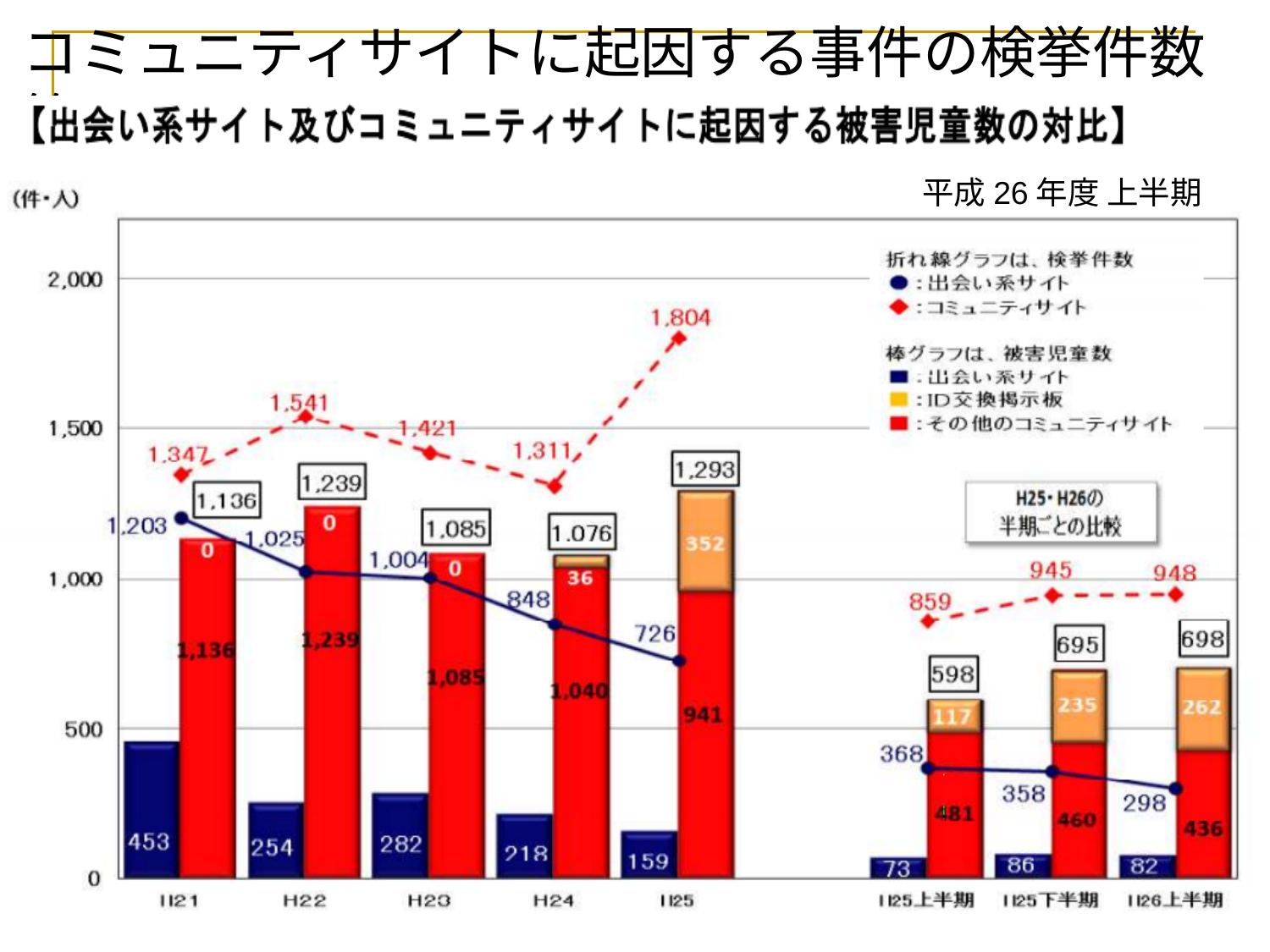
What is the value of the 出会い系サイト line (検挙件数) for H21? 1,203 How many categories are shown on the x axis? 8 What unit is shown at the top of the y axis? (件・人) Does the 出会い系サイト line rise or fall from H21 to H25? fall What is the total of the stacked bar (被害児童数) for H25? 1,293 What is the value of the コミュニティサイト line (検挙件数) for H25? 1,804 Which category has the lowest value for the 出会い系サイト bar (被害児童数)? H25上半期 What is the difference between the コミュニティサイト line value and the 出会い系サイト line value for H25? 1,078 Which category has the highest value on the コミュニティサイト line? H25 Which is larger for H22: the 出会い系サイト line value or the その他のコミュニティサイト bar value? その他のコミュニティサイト bar value (1,239) What is the value of the ID交換掲示板 segment in the H26上半期 bar? 262 How many series does the legend list? 5